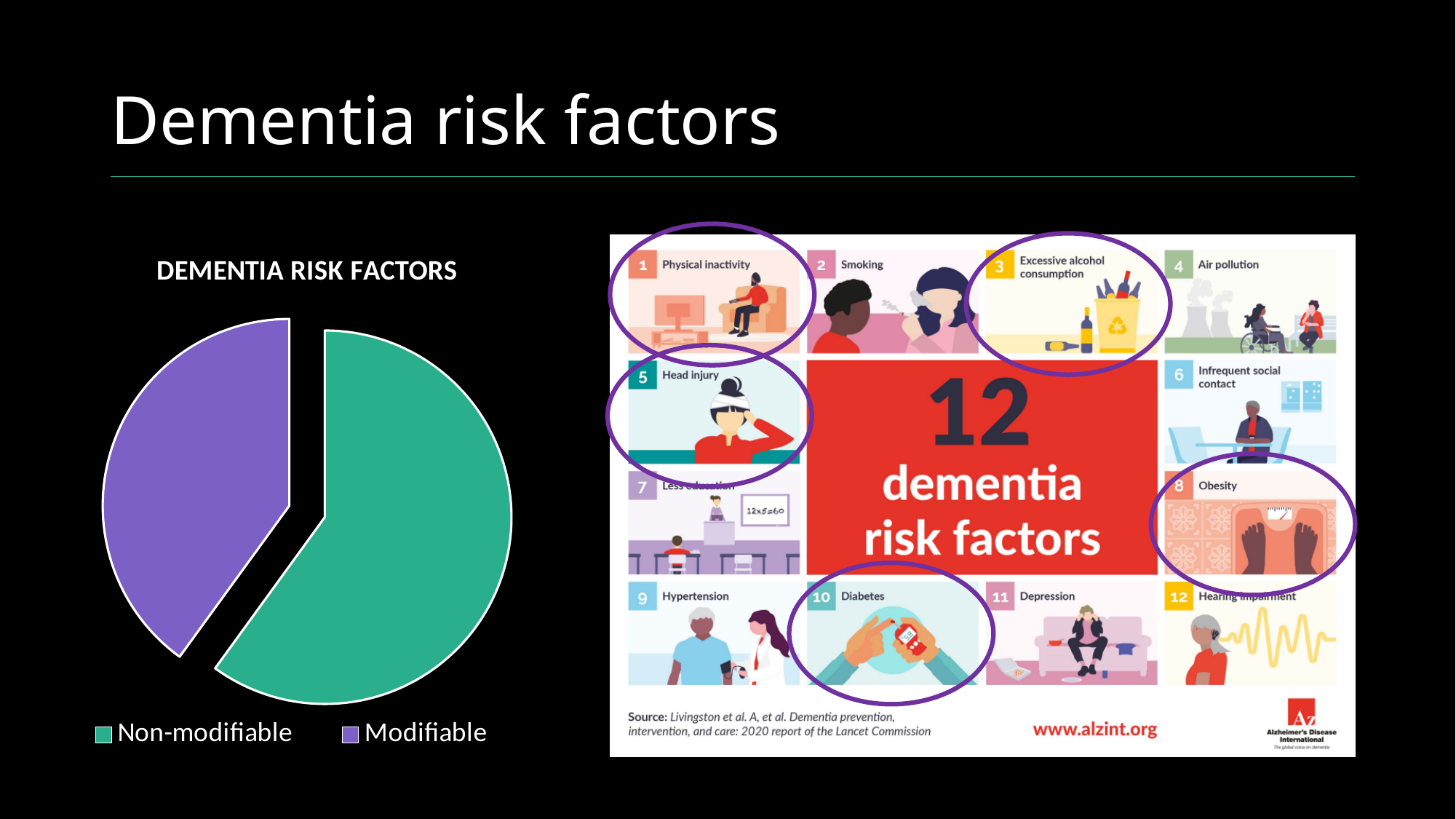
Which slice of the pie chart is the smallest? Modifiable How many slices does the pie chart have? 2 Which slice of the pie chart is the largest? Non-modifiable What is the title of the pie chart? DEMENTIA RISK FACTORS What kind of chart is shown on the slide? pie chart What colour is the Modifiable slice in the pie chart? purple How many entries does the pie chart's legend list? 2 In the pie chart, which is larger: the Non-modifiable slice or the Modifiable slice? Non-modifiable